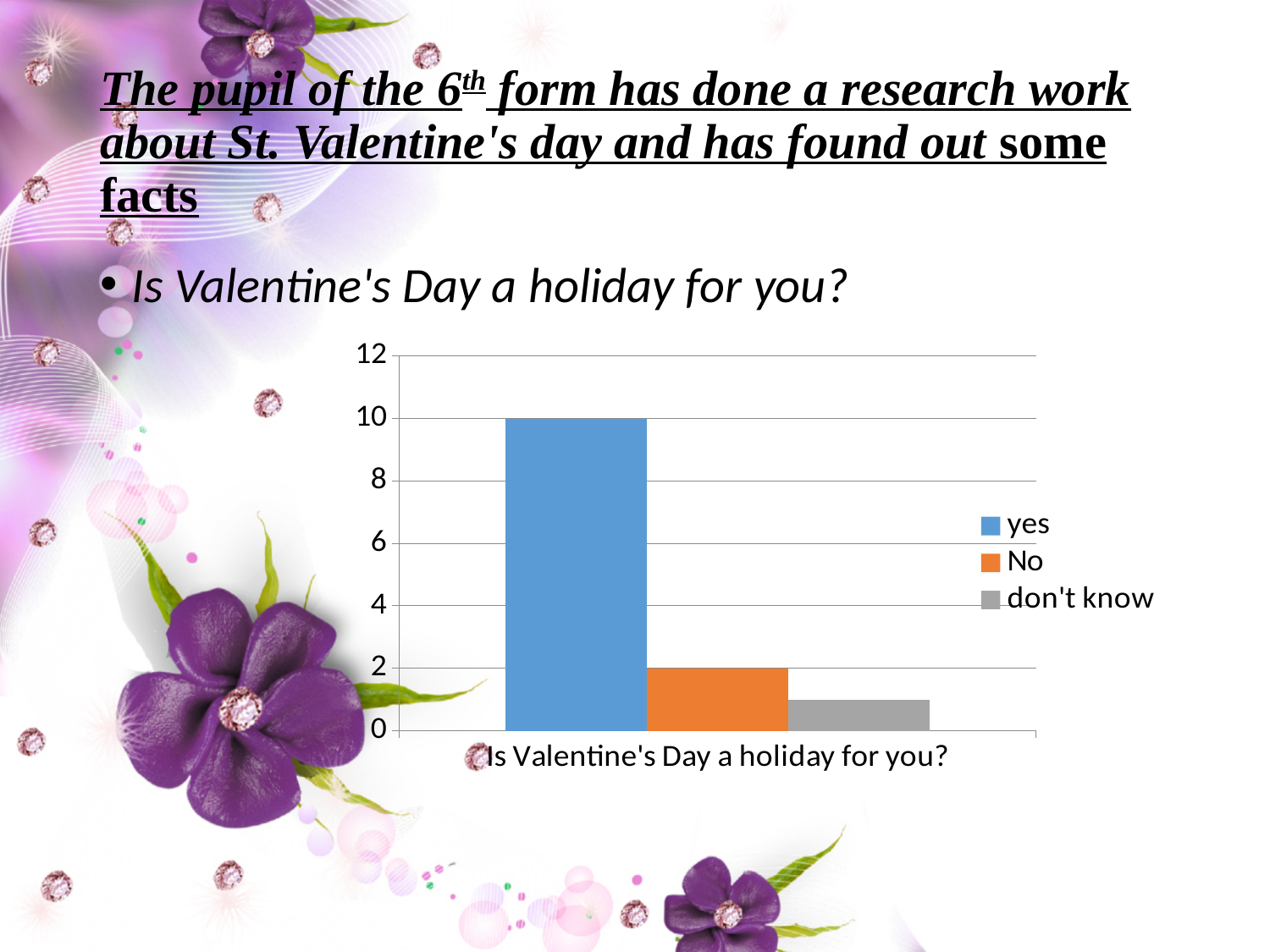
What is the difference between the values for "yes" and "No"? 8 Is the value for "don't know" greater or less than 2? less Which is larger, the value for "No" or the value for "don't know"? No What kind of chart is shown on the slide? bar chart What is the value for "No"? 2 How many series does the legend list? 3 Which series has the lowest value? don't know What is the value for "yes"? 10 Is the value for "yes" greater or less than 8? greater What is the category label shown on the x axis? Is Valentine's Day a holiday for you? What colour is the bar for "No"? orange Which series has the highest value? yes